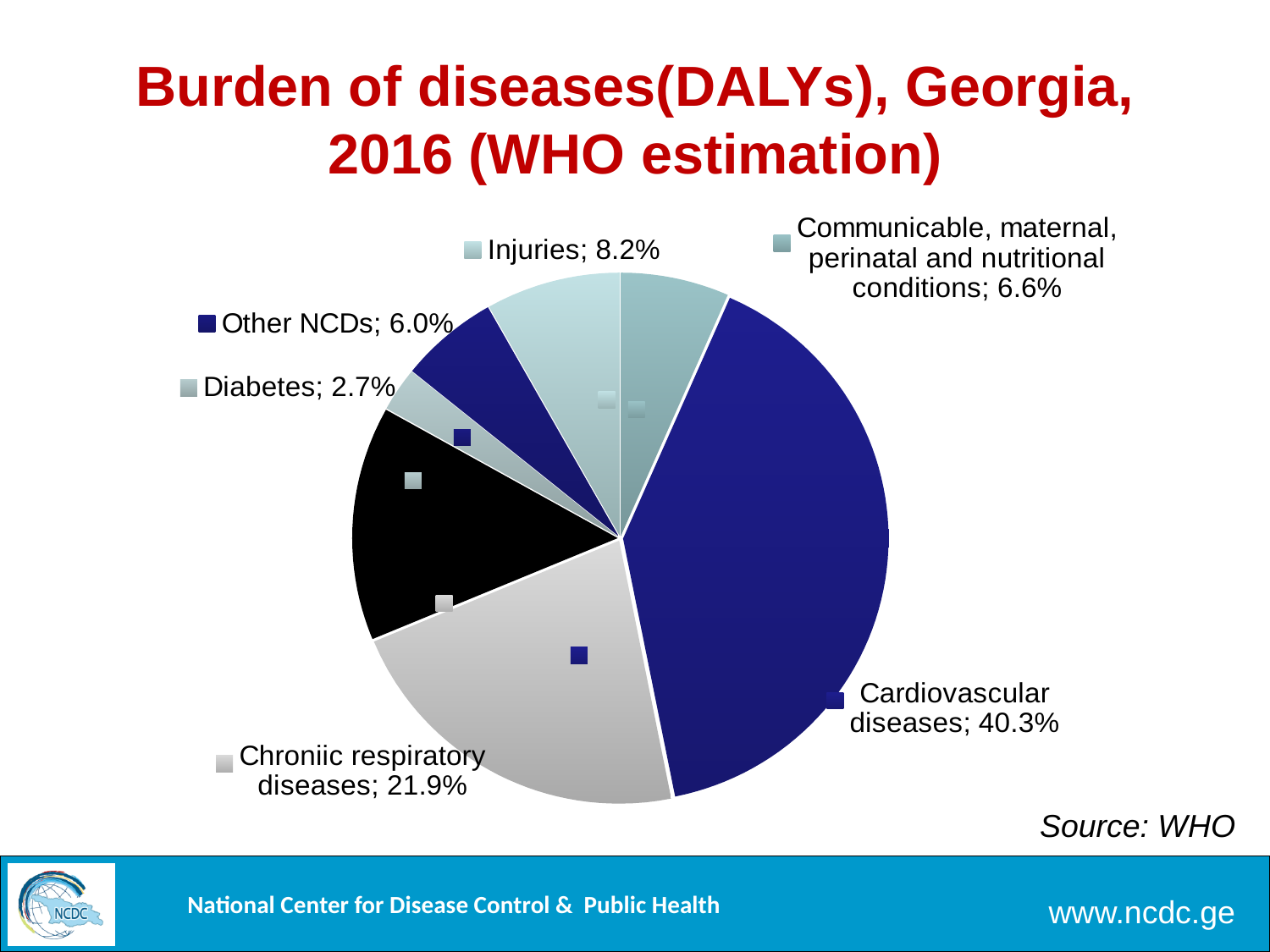
What percentage is shown for communicable, maternal, perinatal and nutritional conditions? 6.6% What percentage does the chart show for chronic respiratory diseases? 21.9% Which is larger: the share for injuries or the share for communicable, maternal, perinatal and nutritional conditions? Injuries Which labelled category has the smallest share? Diabetes What is the value shown for injuries? 8.2% What share of DALYs is attributed to cardiovascular diseases? 40.3% What kind of chart is shown on the slide? Pie chart How many slices does the pie chart have? 7 How many percentage points larger is the cardiovascular diseases share than the chronic respiratory diseases share? 18.4 Which category has the largest slice of the pie? Cardiovascular diseases What share is shown for diabetes? 2.7% What is the source cited for the chart? WHO